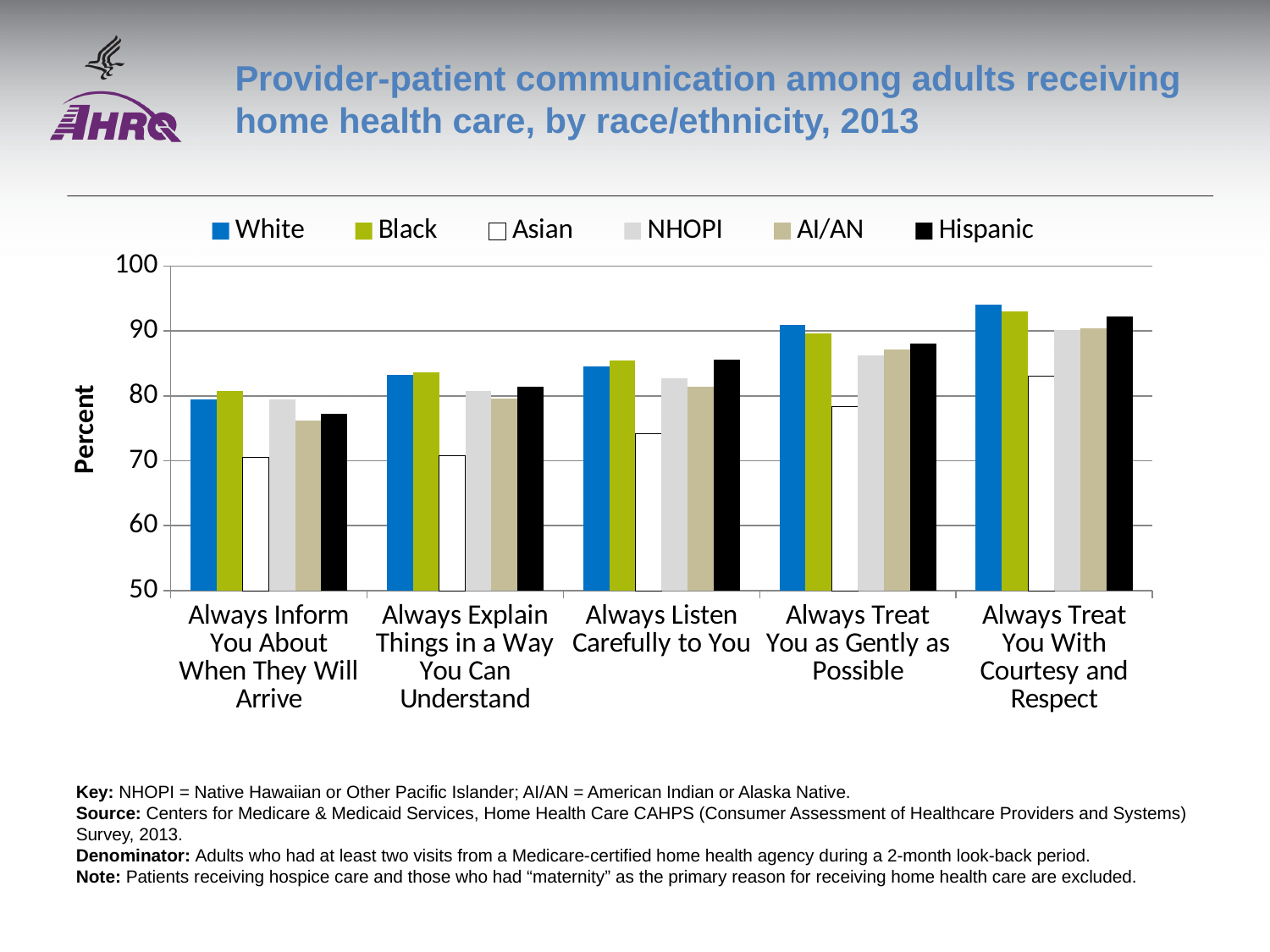
Is the value for Asian in 'Always Listen Carefully to You' greater or less than 80? less In 'Always Treat You as Gently as Possible', which is larger, the value for Asian or the value for NHOPI? NHOPI In 'Always Inform You About When They Will Arrive', which is larger, the value for Black or the value for Asian? Black Do the values for the White series rise or fall moving from left to right across the categories? rise What is the label on the vertical axis of the chart? Percent Which race/ethnicity group has the lowest value for 'Always Inform You About When They Will Arrive'? Asian Is the value for White in 'Always Treat You as Gently as Possible' greater or less than 90? greater How many categories are shown along the x axis? 5 What kind of chart is shown on the slide? bar chart Is the value for Hispanic in 'Always Inform You About When They Will Arrive' greater or less than 80? less For the White series, which category has the highest value? Always Treat You With Courtesy and Respect How many series does the legend list? 6